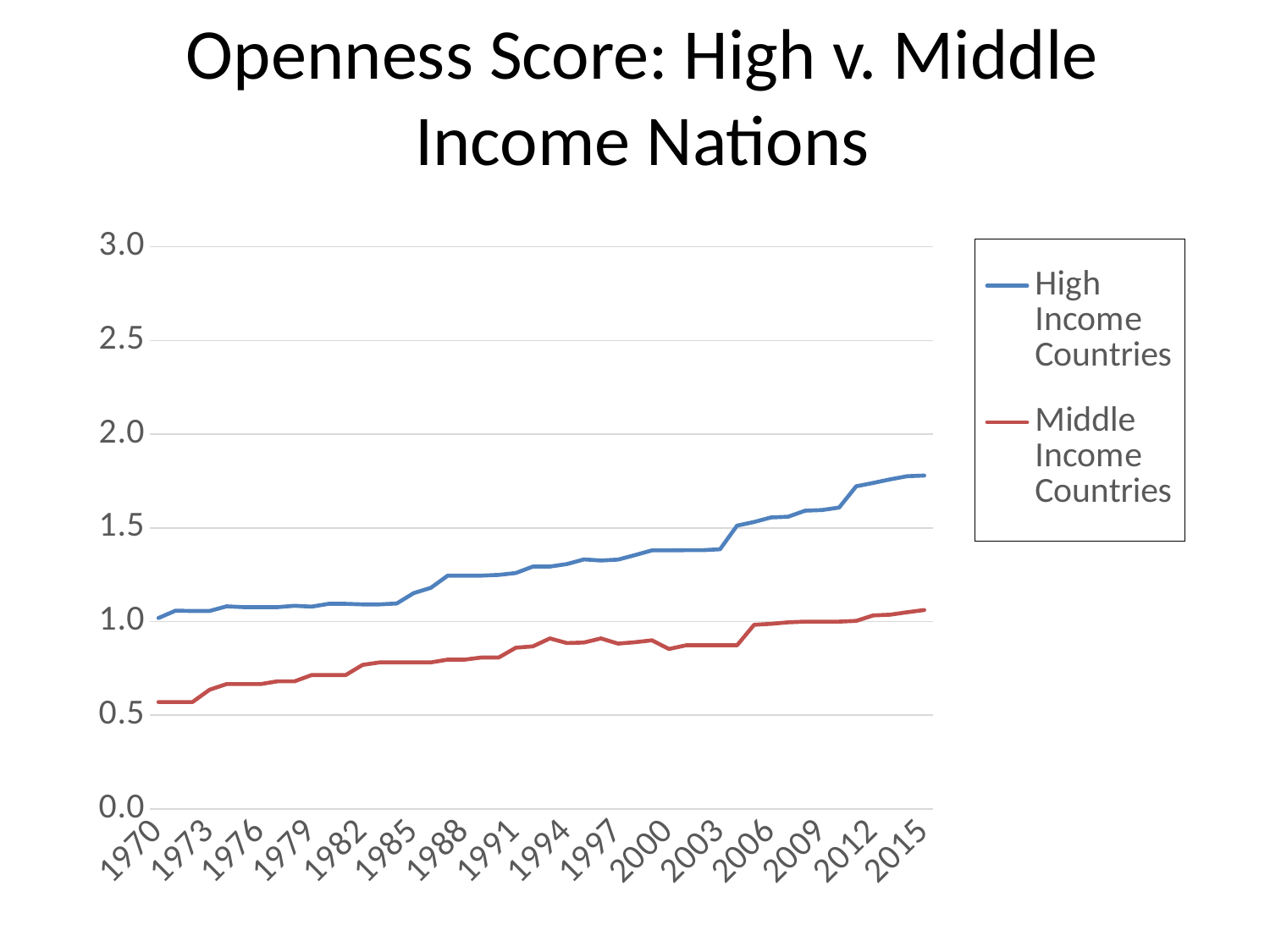
Is the value for Middle Income Countries in 1985 greater or less than 0.5? greater How many year labels are shown on the x axis? 16 In 2000, which series has the larger value, High Income Countries or Middle Income Countries? High Income Countries Is the value for Middle Income Countries in 1994 greater or less than 1.0? less Do the values for High Income Countries generally rise or fall from 1970 to 2015? rise What kind of chart is shown on the slide? line chart What is the title of the chart? Openness Score: High v. Middle Income Nations Is the value for High Income Countries in 1985 greater or less than 1.5? less How many series does the legend list? 2 Which series is drawn in red? Middle Income Countries